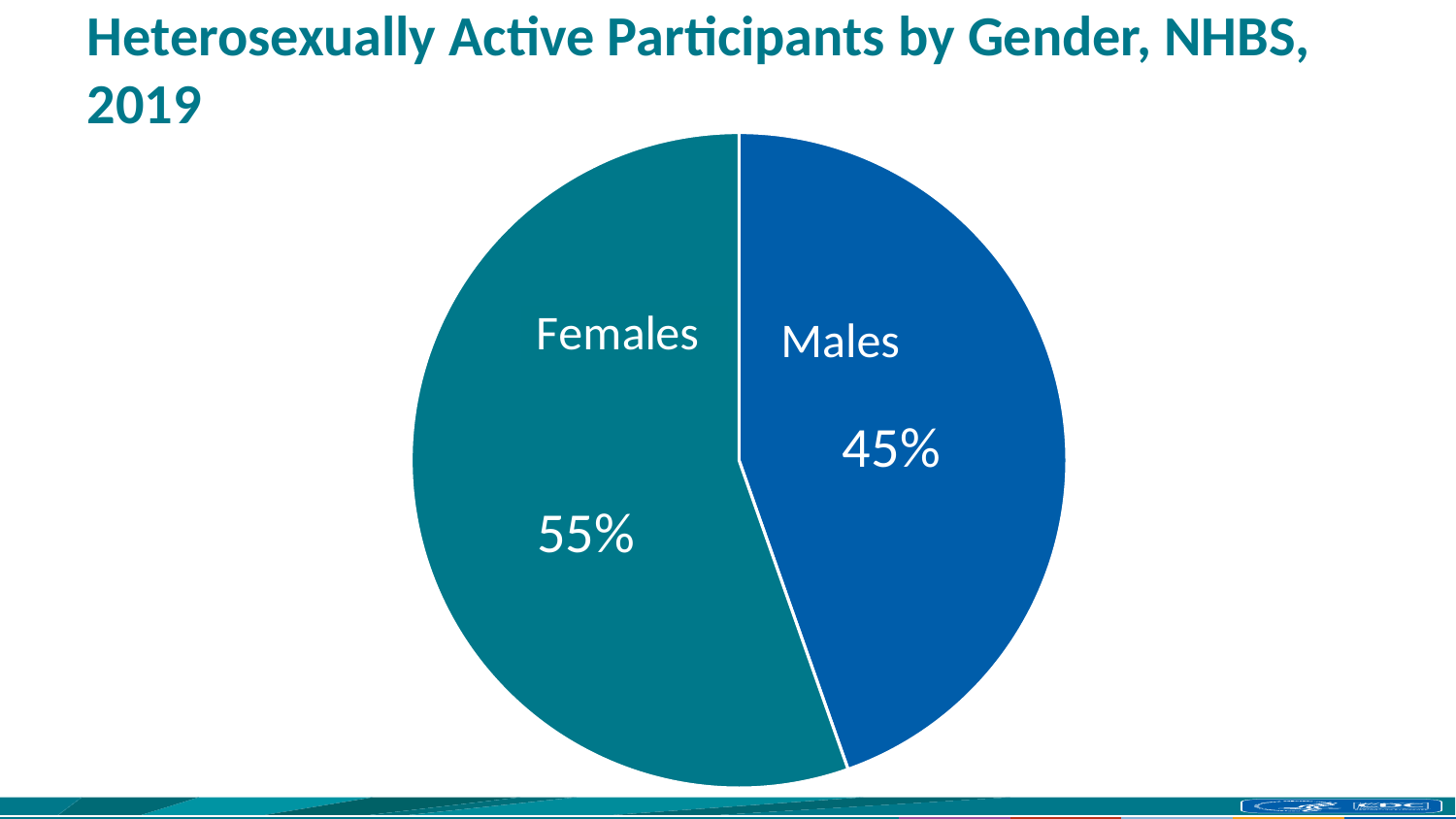
What colour is the Males slice? blue By how many percentage points does the Females share exceed the Males share? 10 percentage points What percentage of heterosexually active participants are Females? 55% How many slices does the pie chart have? 2 What kind of chart is shown on the slide? pie chart Is the share for Females larger or smaller than the share for Males? larger What is the combined share of the Females and Males slices? 100% Is the share for Males greater or less than 50%? less Which gender has the larger share of heterosexually active participants? Females What percentage of heterosexually active participants are Males? 45% What is the title of the chart? Heterosexually Active Participants by Gender, NHBS, 2019 Which gender has the smaller share of heterosexually active participants? Males